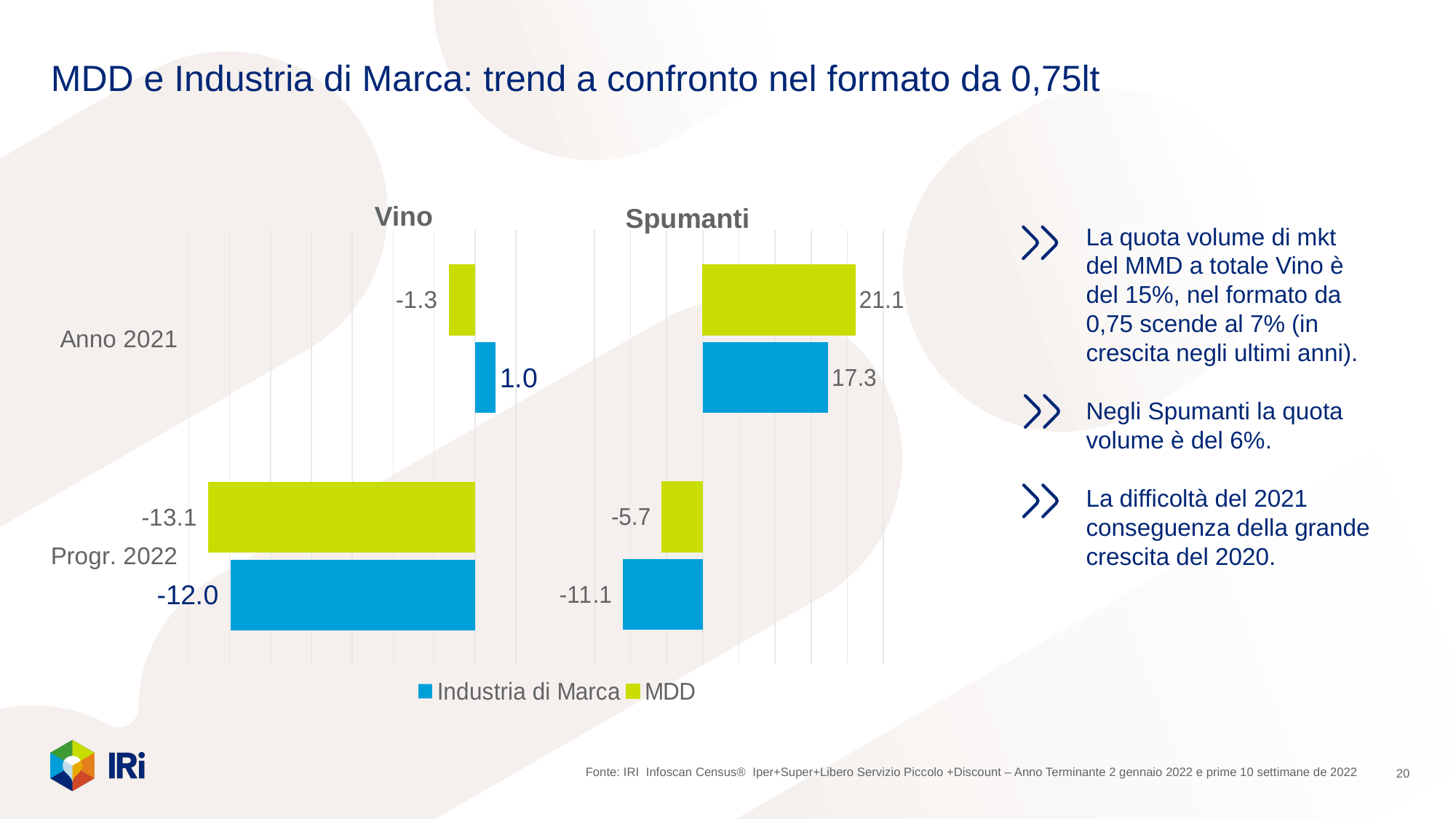
In the Spumanti chart, does the MDD value rise or fall from Anno 2021 to Progr. 2022? fall In the Spumanti chart, what is the value for MDD in Anno 2021? 21.1 How many series does the legend list? 2 In the Spumanti chart, what is the difference between the MDD value and the Industria di Marca value in Anno 2021? 3.8 In the Vino chart, which series has the lower value in Progr. 2022, Industria di Marca or MDD? MDD In the Vino chart, what is the value for MDD in Anno 2021? -1.3 In the Vino chart, what is the value for Industria di Marca in Progr. 2022? -12.0 In the Spumanti chart, what is the value for Industria di Marca in Progr. 2022? -11.1 In the Spumanti chart, which series has the higher value in Anno 2021, Industria di Marca or MDD? MDD What kind of chart is the Spumanti chart? bar chart In the Vino chart, what is the difference between the Industria di Marca value in Anno 2021 and in Progr. 2022? 13.0 How many categories are shown in the Vino chart? 2